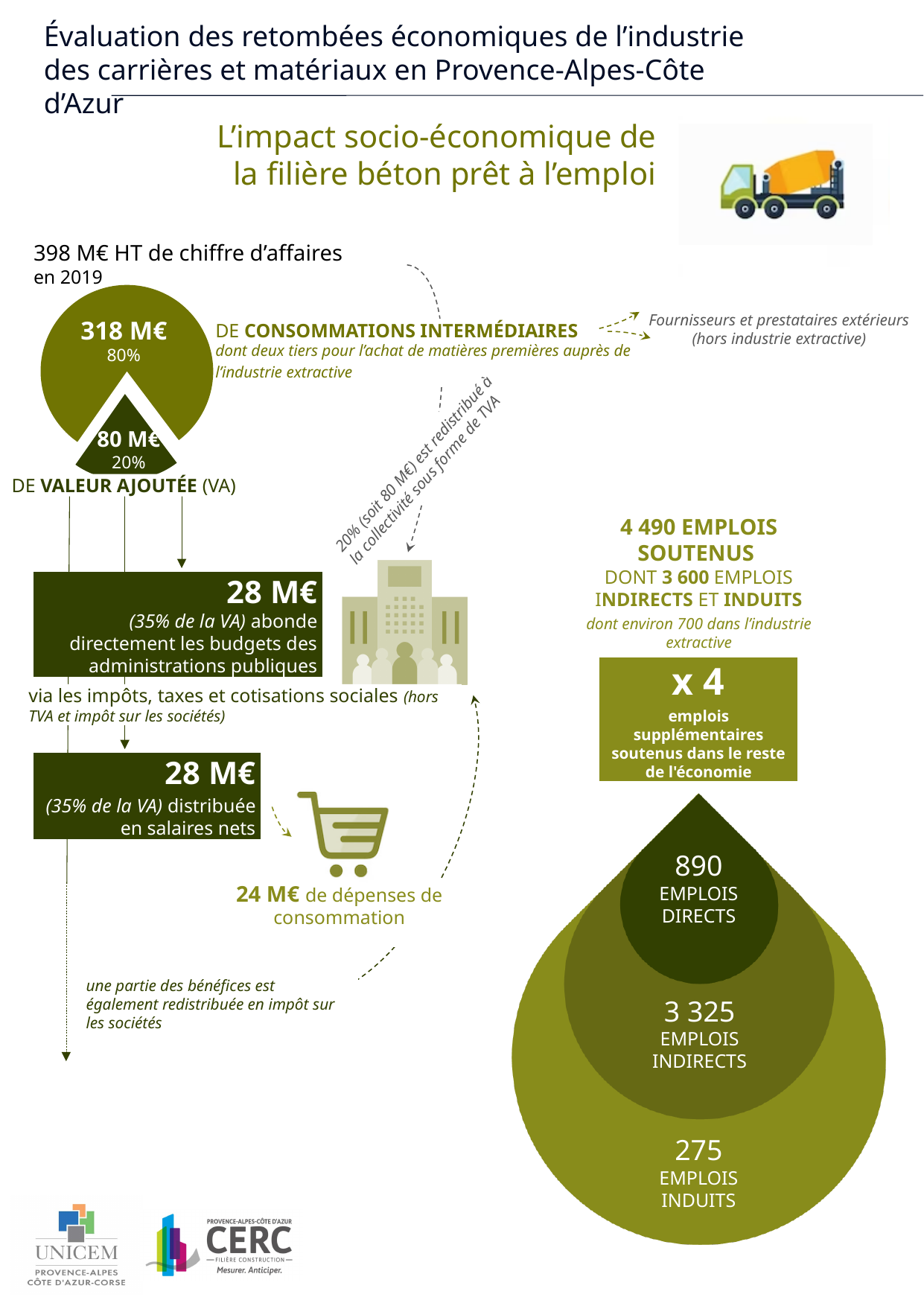
In the nested circles chart on the right, how many emplois directs are shown? 890 In the nested circles chart on the right, what is the difference between emplois indirects and emplois directs? 2 435 In the pie chart on the left, how many slices are there? 2 In the nested circles chart on the right, how many emplois indirects are shown? 3 325 What kind of chart is the chart on the left showing 318 M€ and 80 M€? Pie chart In the nested circles chart on the right, which category has the lowest number of jobs? Emplois induits In the nested circles chart on the right, how many emplois induits are shown? 275 In the pie chart on the left, what share does valeur ajoutée represent? 20% In the pie chart on the left, what is the difference between consommations intermédiaires and valeur ajoutée? 238 M€ In the pie chart on the left, what is the value for valeur ajoutée (VA)? 80 M€ In the pie chart on the left, what is the value for consommations intermédiaires? 318 M€ In the nested circles chart on the right, which category has the highest number of jobs? Emplois indirects